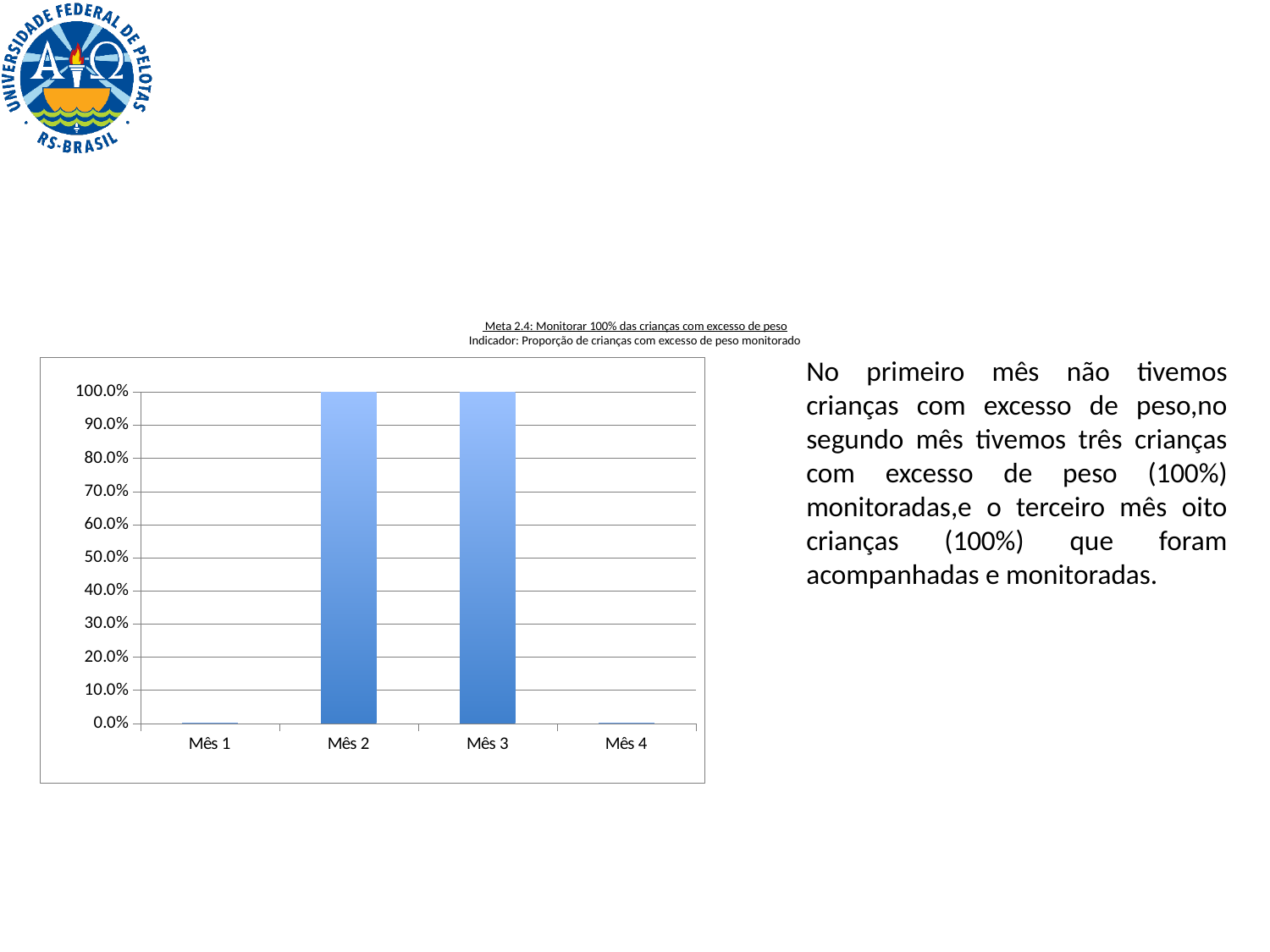
Which is larger, the value for Mês 2 or the value for Mês 1? Mês 2 What is the value for Mês 1 in the chart? 0.0% Which is larger, the value for Mês 3 or the value for Mês 4? Mês 3 Does the value rise or fall from Mês 3 to Mês 4? fall What is the difference between the value for Mês 2 and the value for Mês 1? 100.0% What is the value for Mês 4 in the chart? 0.0% Is the value for Mês 2 greater or less than 50.0%? greater What type of chart is shown on the slide? bar chart What is the value for Mês 3 in the chart? 100.0% How many categories (months) are shown on the x axis of the chart? 4 What is the value for Mês 2 in the chart? 100.0% What is the indicator named in the chart title? Proporção de crianças com excesso de peso monitorado